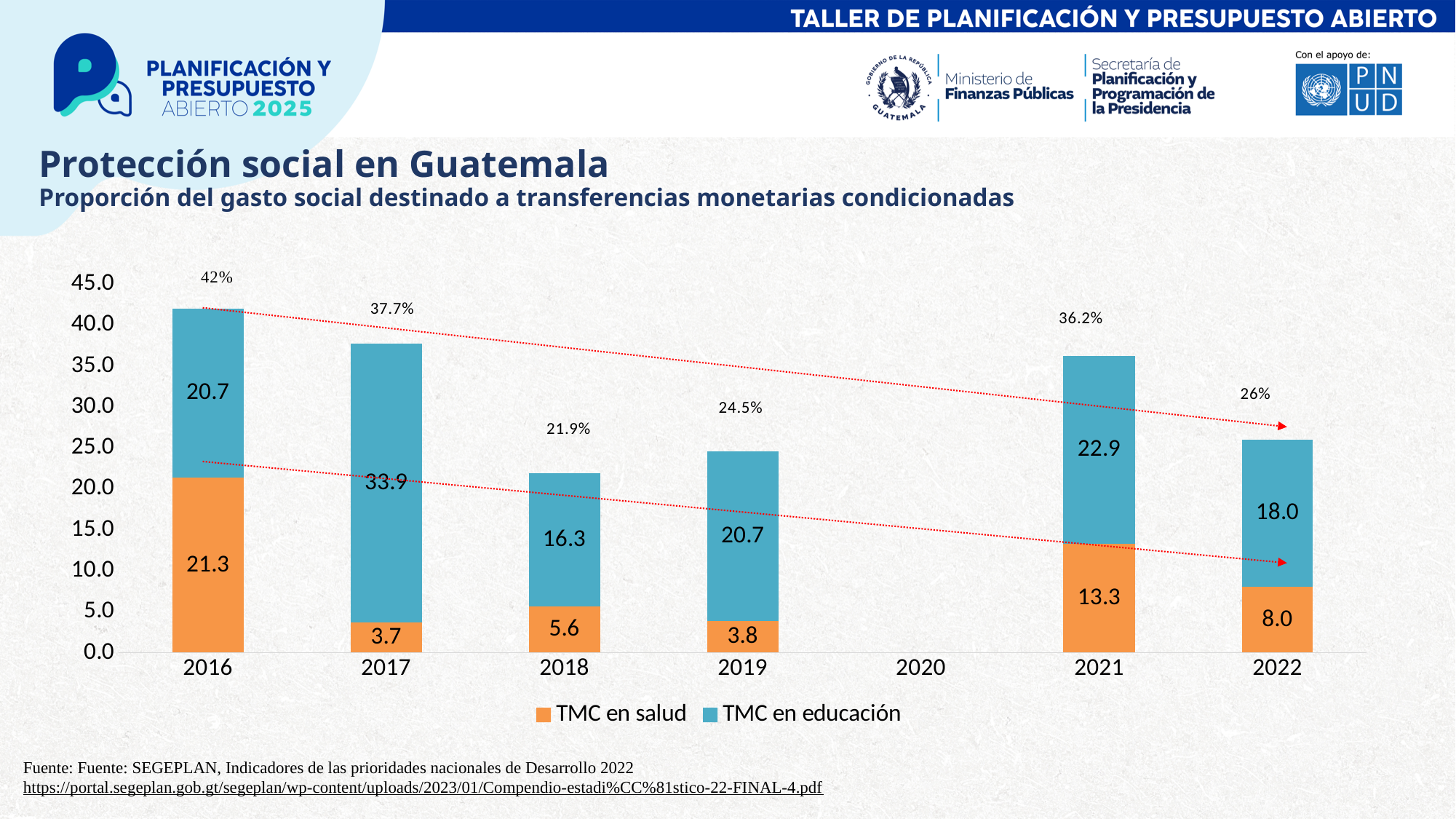
Do the total percentages labelled above the bars generally rise or fall from 2016 to 2022? Fall What is the value for TMC en salud in 2016? 21.3 Which year has the lowest value for TMC en salud? 2017 What is the value for TMC en salud in 2022? 8.0 Which is larger in 2018, TMC en salud or TMC en educación? TMC en educación What kind of chart is shown on the slide? Stacked bar chart How many series does the legend list? 2 Which year has the highest value for TMC en educación? 2017 What is the difference between TMC en educación and TMC en salud in 2021? 9.6 What is the total labelled for the 2018 stacked bar? 21.9% What total percentage is labelled above the 2021 bar? 36.2% What is the value for TMC en educación in 2017? 33.9